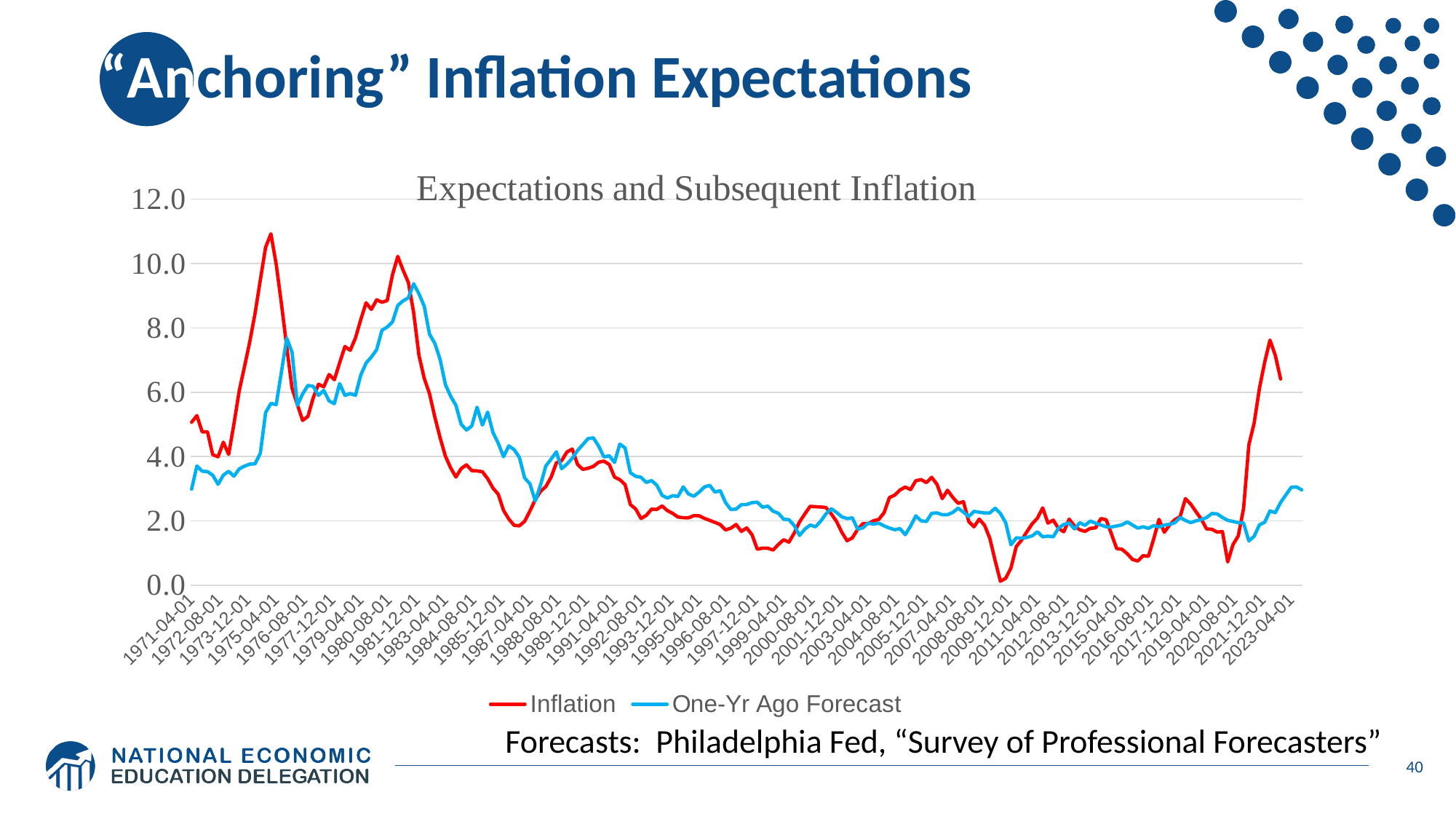
What is the title of the chart? Expectations and Subsequent Inflation At 1975-04-01, which series has the higher value, Inflation or One-Yr Ago Forecast? Inflation What kind of chart is shown on the slide? Line chart Does the Inflation series rise or fall between 1981-12-01 and 1985-12-01? fall Is the value of the Inflation series around 2021-12-01 greater or less than 6.0? greater Which series is drawn in red? Inflation How many series does the legend list? 2 Is the value of the Inflation series around 2009-12-01 greater or less than 2.0? less Is the peak value of the One-Yr Ago Forecast series around 1981-12-01 greater or less than 8.0? greater At 1983-04-01, which series has the higher value, Inflation or One-Yr Ago Forecast? One-Yr Ago Forecast